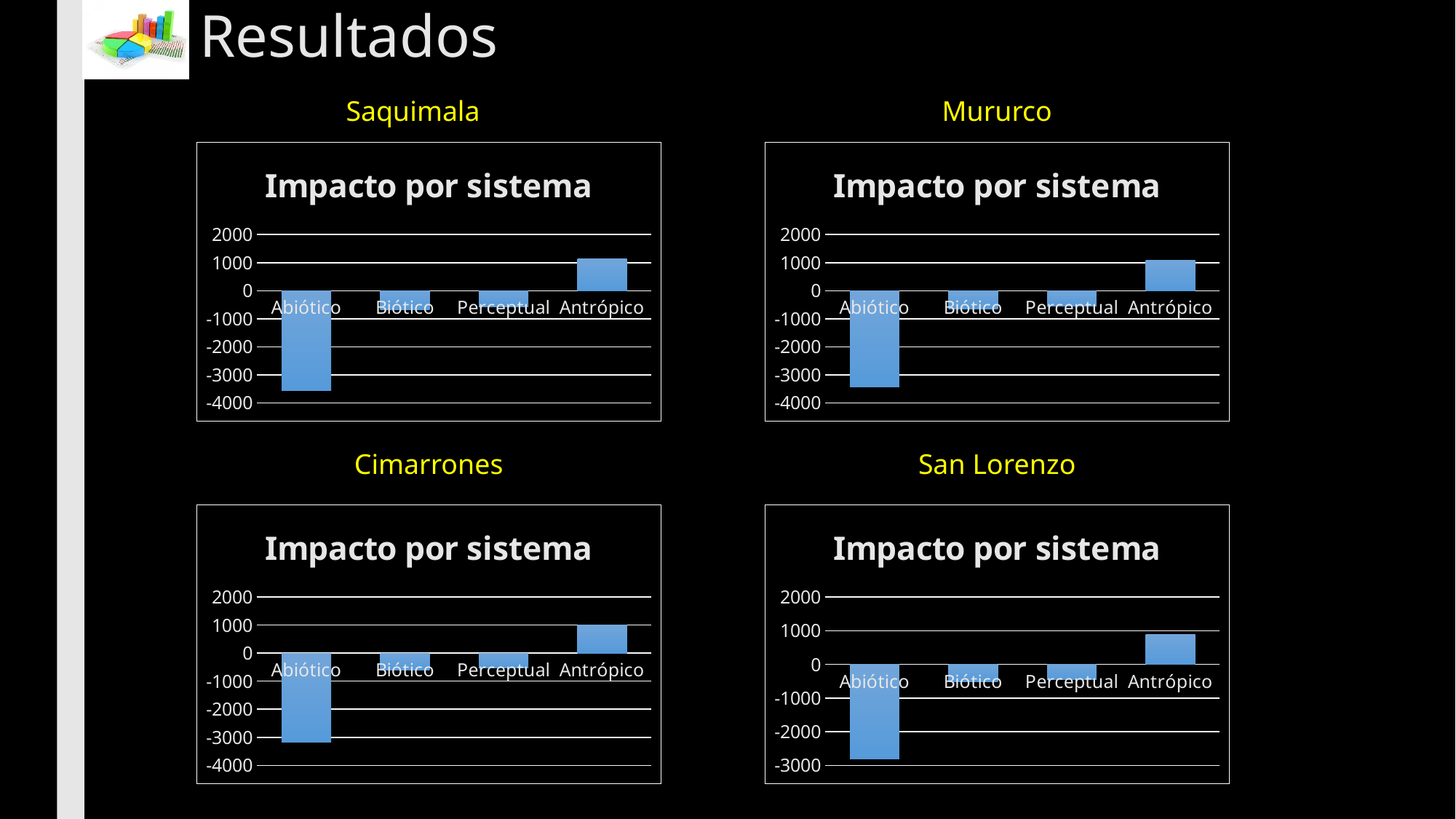
In the Mururco chart, is the value for Abiótico greater or less than -3000? less What is the title shown inside each of the four charts? Impacto por sistema In the Saquimala chart, which category has the highest value? Antrópico In the Saquimala chart, which category has the lowest value? Abiótico What type of chart is used for Mururco? bar chart In the Mururco chart, which category has the highest value? Antrópico In the San Lorenzo chart, is the value for Abiótico greater or less than -2000? less How many categories are shown in the Cimarrones chart? 4 In the San Lorenzo chart, is the value for Antrópico greater or less than 1000? less In the Cimarrones chart, which category has the lowest value? Abiótico In the San Lorenzo chart, which is larger, the value for Biótico or the value for Antrópico? Antrópico